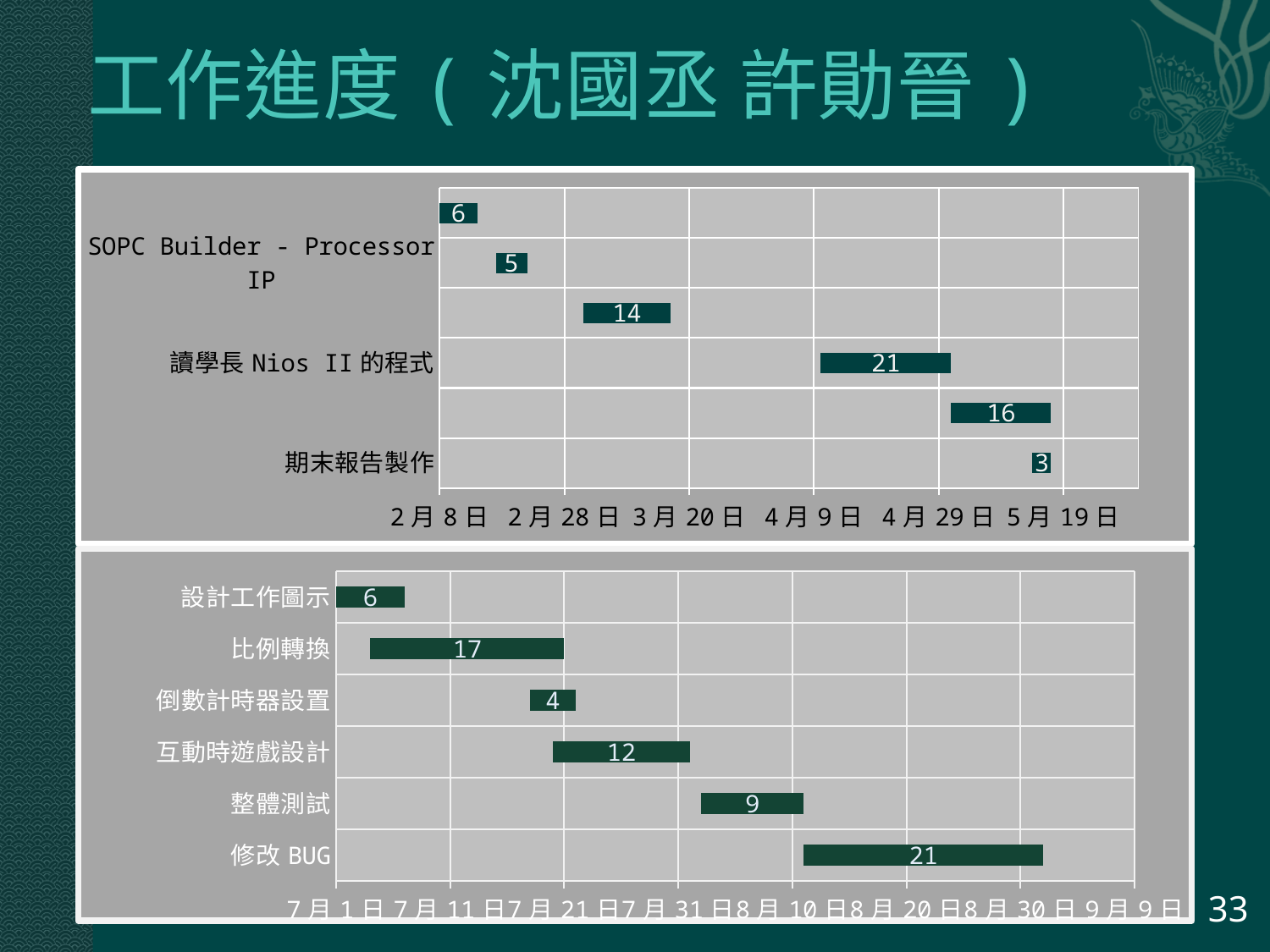
In the bottom chart, what is the value for 比例轉換? 17 In the top chart, what is the value for 讀學長 Nios II 的程式? 21 In the bottom chart, which is larger, the value for 設計工作圖示 or the value for 整體測試? 整體測試 In the bottom chart, what is the value for 修改 BUG? 21 In the bottom chart, what is the difference between the values for 互動時遊戲設計 and 整體測試? 3 What kind of chart is the bottom chart? bar chart In the bottom chart, which category has the highest value? 修改 BUG How many categories are shown in the bottom chart? 6 In the bottom chart, which category has the lowest value? 倒數計時器設置 In the top chart, what is the value for 期末報告製作? 3 In the bottom chart, what is the value for 倒數計時器設置? 4 In the top chart, what is the difference between the values for 讀學長 Nios II 的程式 and 期末報告製作? 18